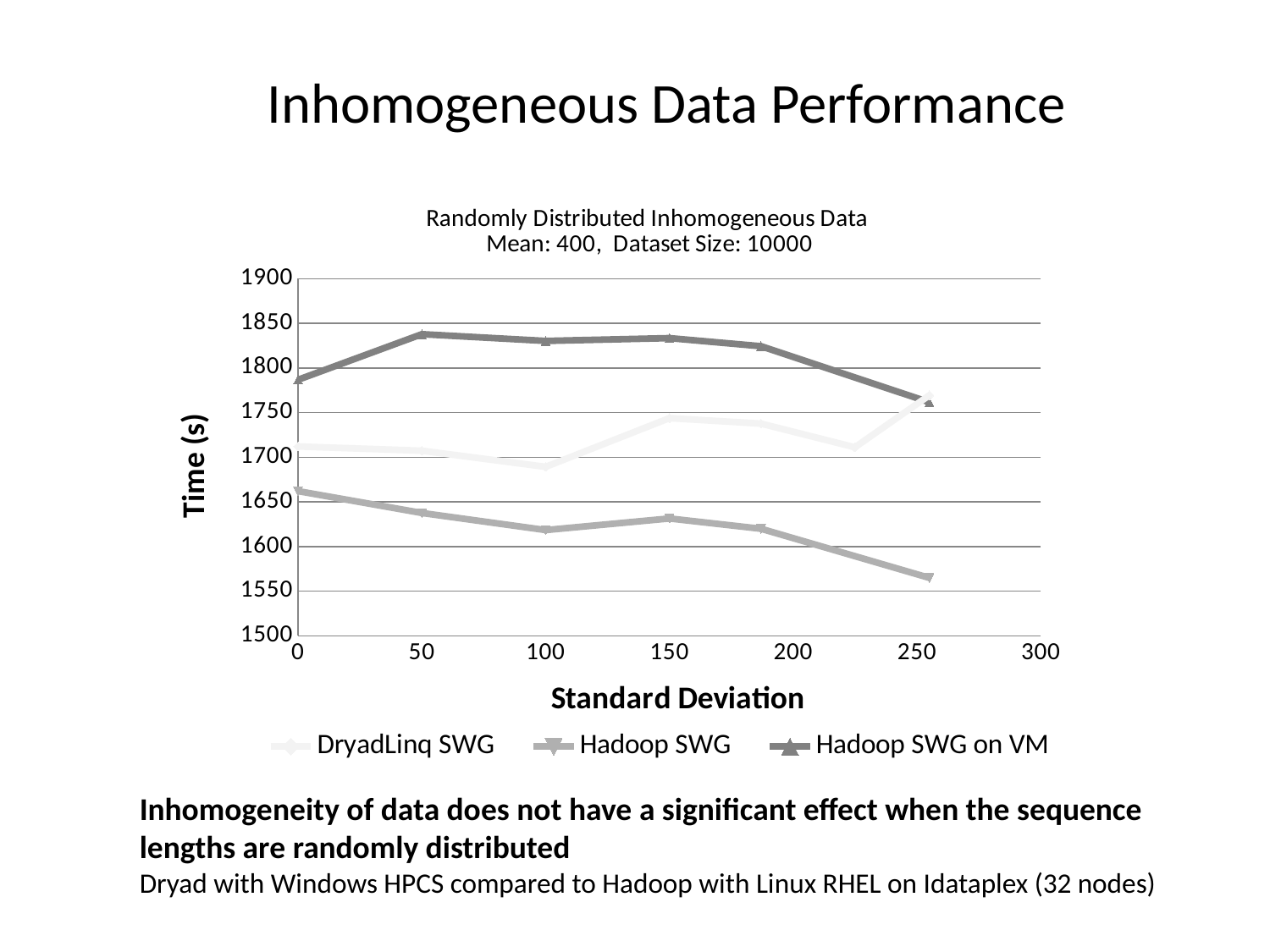
Is the value for Hadoop SWG at standard deviation 0 greater or less than 1700? less Do the values for Hadoop SWG generally rise or fall as standard deviation increases? fall Is the value for Hadoop SWG at standard deviation 250 greater or less than 1600? less Which series has the lowest values across the chart? Hadoop SWG What is the label of the y axis? Time (s) What kind of chart is shown on the slide? line chart Is the value for DryadLinq SWG at standard deviation 150 greater or less than 1700? greater At standard deviation 0, which is larger: Hadoop SWG on VM or DryadLinq SWG? Hadoop SWG on VM How many series does the legend list? 3 What is the title of the chart? Randomly Distributed Inhomogeneous Data Mean: 400, Dataset Size: 10000 Which series has the highest values across the chart? Hadoop SWG on VM